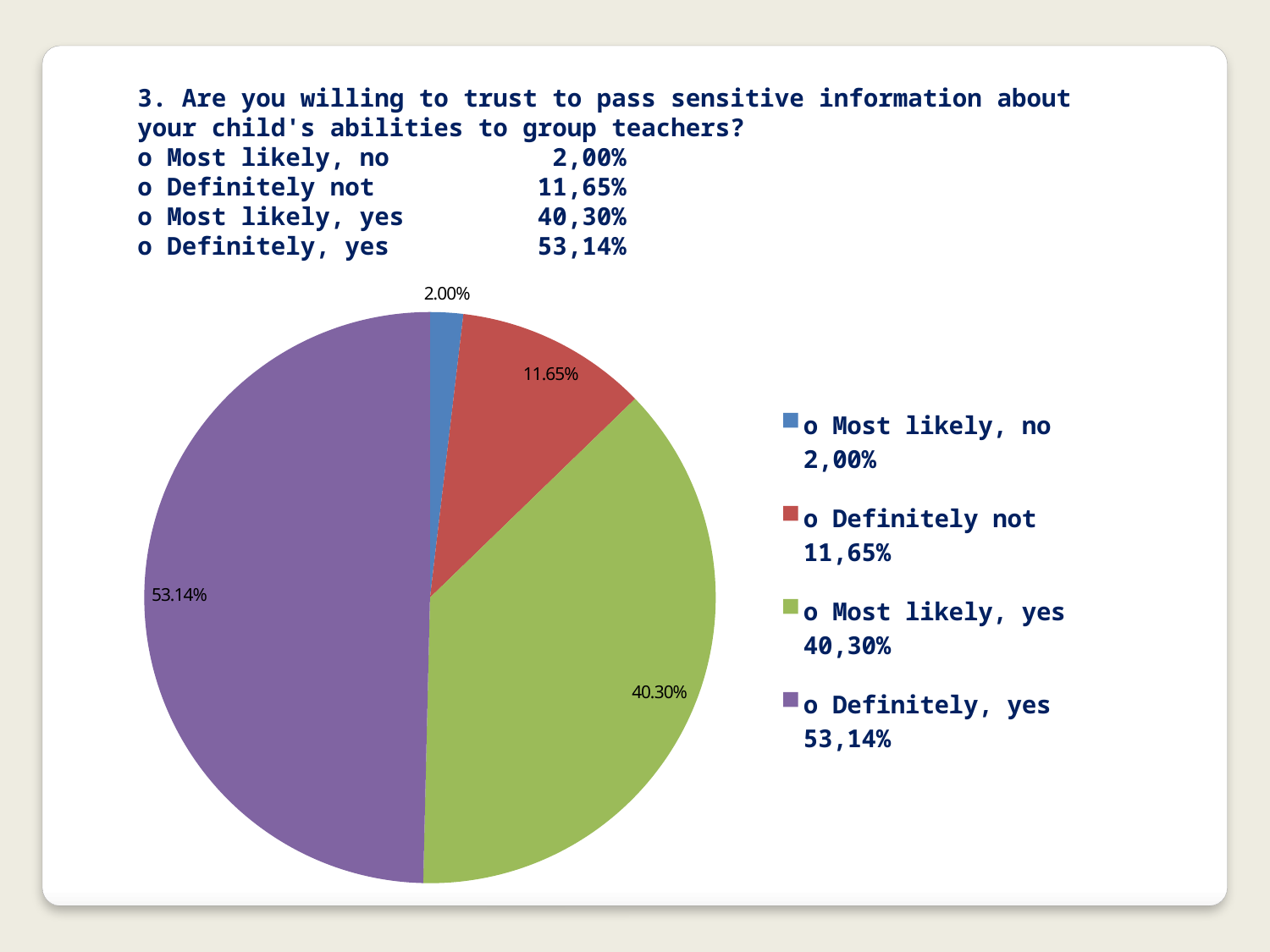
How many slices does the pie chart have? 4 What is the value shown for the "Definitely not" slice? 11.65% What is the value shown for the "Definitely, yes" slice? 53.14% What colour is the "Definitely, yes" slice? purple What is the value shown for the "Most likely, no" slice? 2.00% What is the value shown for the "Most likely, yes" slice? 40.30% What is the difference between the "Definitely, yes" and "Most likely, yes" values? 12.84% Which category has the largest slice of the pie? Definitely, yes What kind of chart is shown on the slide? pie chart Which category has the smallest slice of the pie? Most likely, no How many entries does the legend list? 4 Which is larger, the "Definitely not" slice or the "Most likely, yes" slice? Most likely, yes